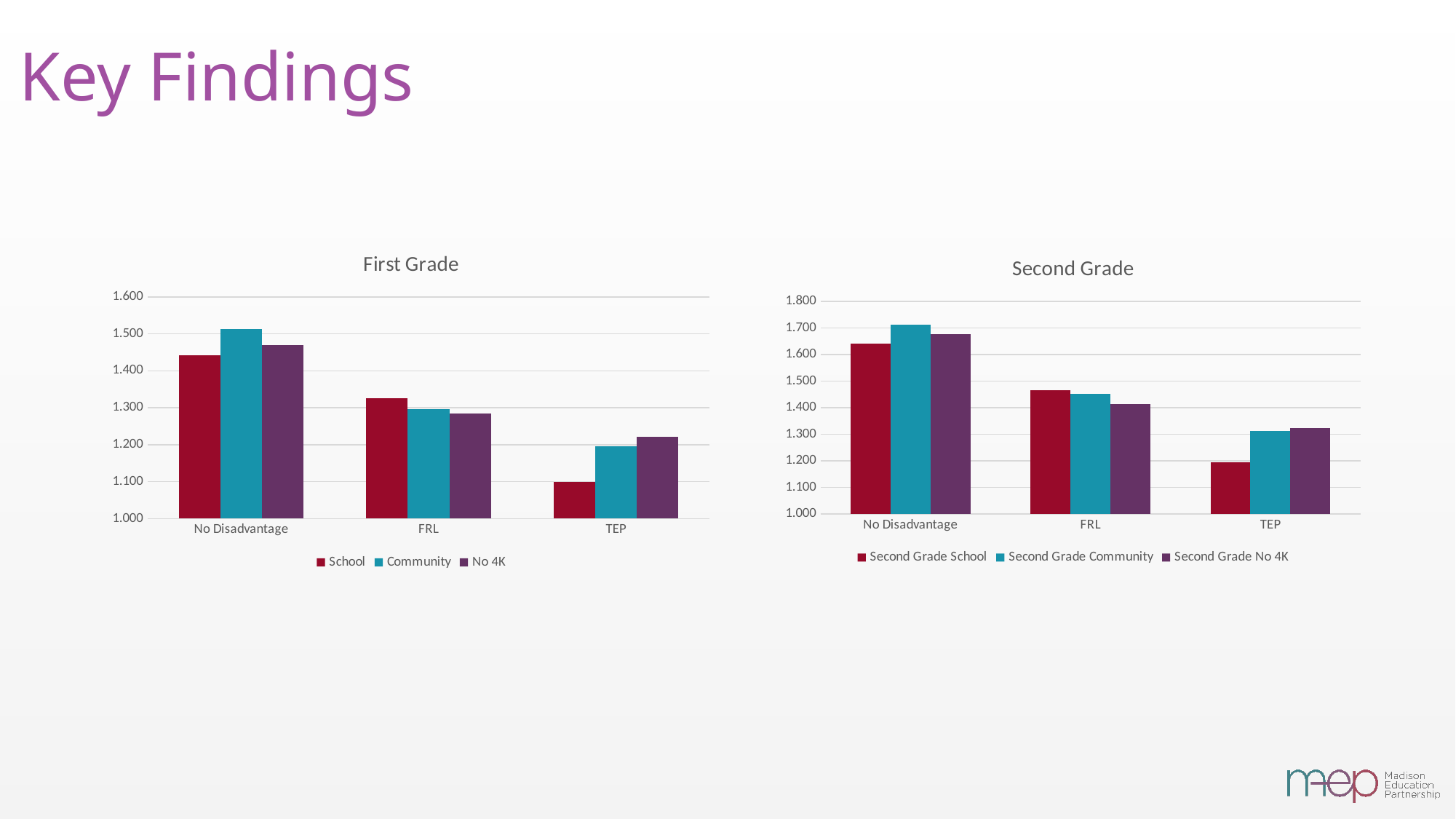
How many series does the legend of the First Grade chart list? 3 In the Second Grade chart, do the Second Grade School values rise or fall from No Disadvantage to TEP? fall In the First Grade chart, which category has the highest Community bar? No Disadvantage What is the title of the chart on the right side of the slide? Second Grade In the First Grade chart, which category has the lowest School bar? TEP In the First Grade chart, is the School value for TEP greater or less than 1.200? less How many categories are shown on the x axis of the Second Grade chart? 3 In the Second Grade chart, which is larger for TEP: Second Grade School or Second Grade Community? Second Grade Community What kind of chart is the First Grade chart? bar chart In the First Grade chart, which is larger for No Disadvantage: School or No 4K? No 4K In the First Grade chart, is the Community value for No Disadvantage greater or less than 1.500? greater